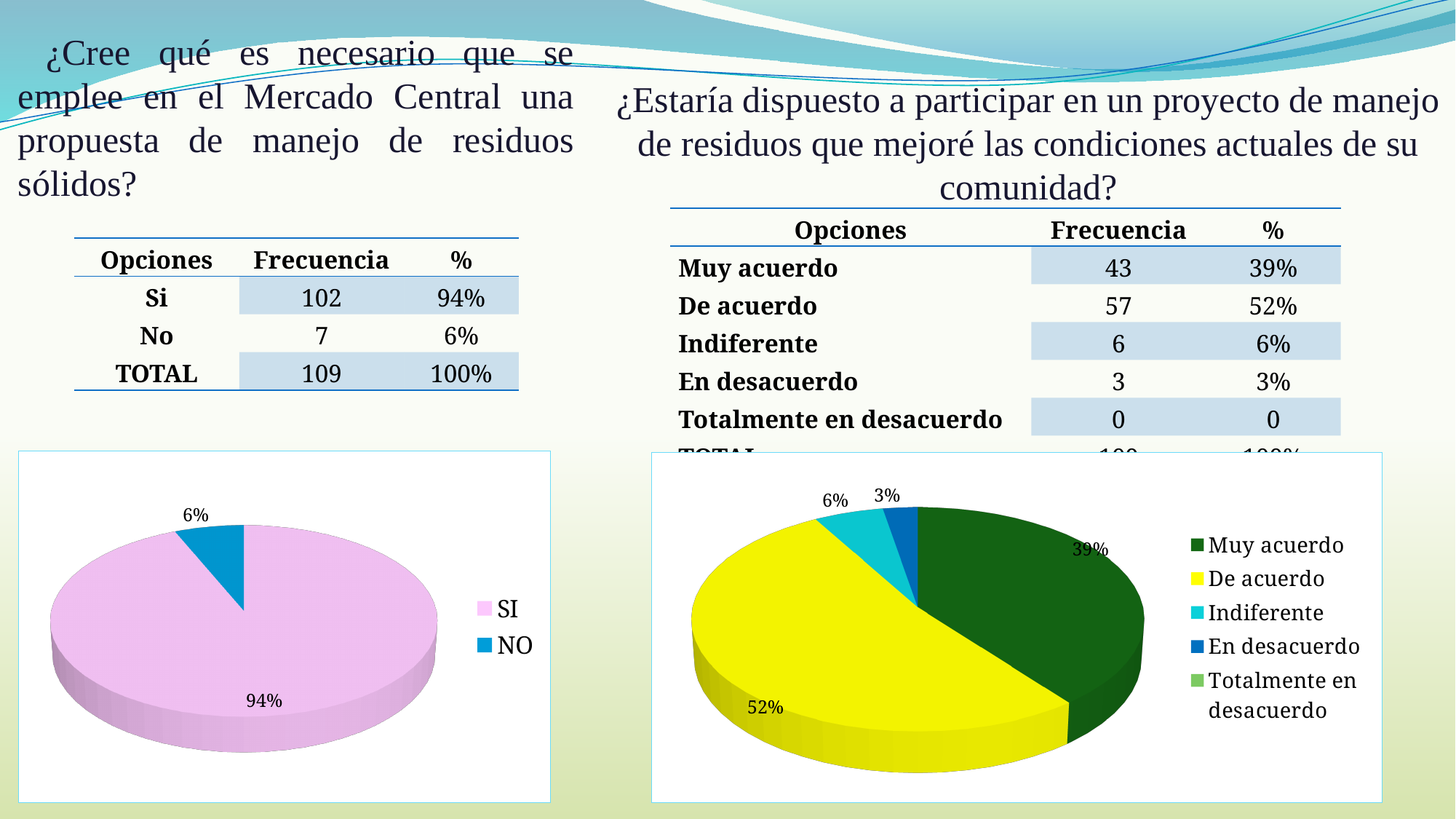
In the left pie chart, what share does the NO slice have? 6% In the right pie chart, what is the difference between the De acuerdo share and the Muy acuerdo share? 13% In the right pie chart, which slice is the largest? De acuerdo How many entries does the legend of the left pie chart list? 2 In the right pie chart, which is larger, the Indiferente slice or the En desacuerdo slice? Indiferente What kind of chart is the left chart on the slide? pie chart How many entries does the legend of the right pie chart list? 5 In the right pie chart, what share does the Indiferente slice have? 6% In the left pie chart, what share does the SI slice have? 94% In the left pie chart, which slice is the largest? SI